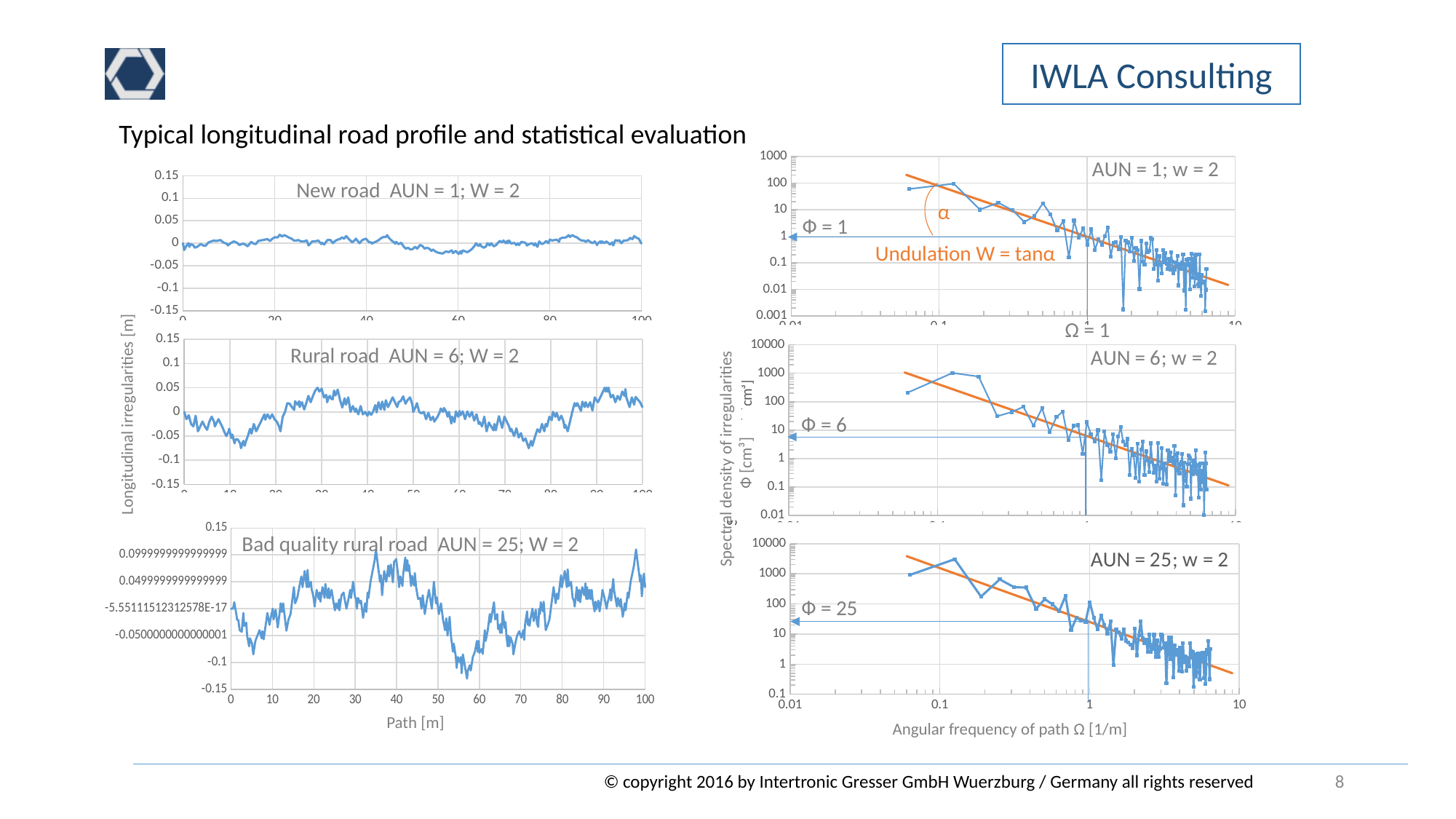
How many charts are shown on the slide? 6 Which road profile shows larger irregularities, the New road chart or the Bad quality rural road chart? Bad quality rural road What is the maximum value shown on the x axis of the bottom-left chart (Bad quality rural road)? 100 In the middle-right chart (AUN = 6; w = 2), what Φ value is marked by the horizontal arrow? Φ = 6 In the bottom-left chart (Bad quality rural road), is the highest value of the profile greater or less than 0.05? greater What is the title of the top-left chart? New road AUN = 1; W = 2 In the bottom-right chart (AUN = 25; w = 2), what Φ value is marked by the horizontal arrow? Φ = 25 In the top-right chart (AUN = 1; w = 2), what Ω value is marked by the vertical line? Ω = 1 In the right-hand spectral density charts, do the values rise or fall as the angular frequency increases? fall In the top-left chart (New road), is the highest value of the profile greater or less than 0.05? less What kind of chart is the top-left chart titled 'New road AUN = 1; W = 2'? line chart In the top-right chart (AUN = 1; w = 2), what is the orange annotation text below the fitted line? Undulation W = tanα